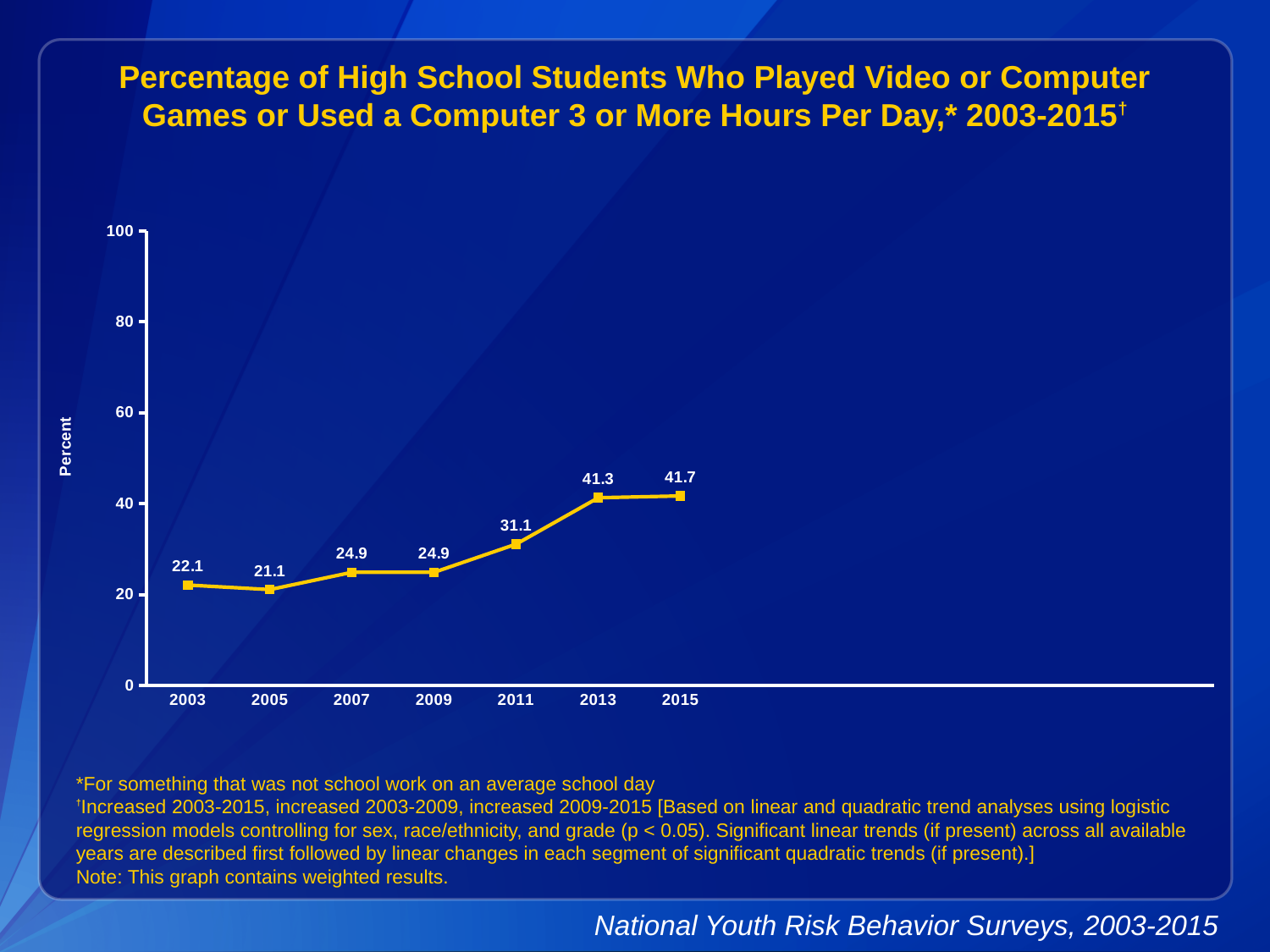
What percentage of high school students played video or computer games or used a computer 3 or more hours per day in 2015? 41.7 What kind of chart is shown on the slide? Line chart Overall, do the values rise or fall from 2003 to 2015? Rise Which year had the lowest percentage? 2005 What is the difference between the 2013 value and the 2011 value? 10.2 What was the value for 2011? 31.1 How many years are plotted on the chart? 7 Is the value for 2013 greater or less than 40? greater Which year had the highest percentage? 2015 What was the value for 2003? 22.1 What is the difference between the 2015 value and the 2003 value? 19.6 Which year had a higher value, 2007 or 2011? 2011